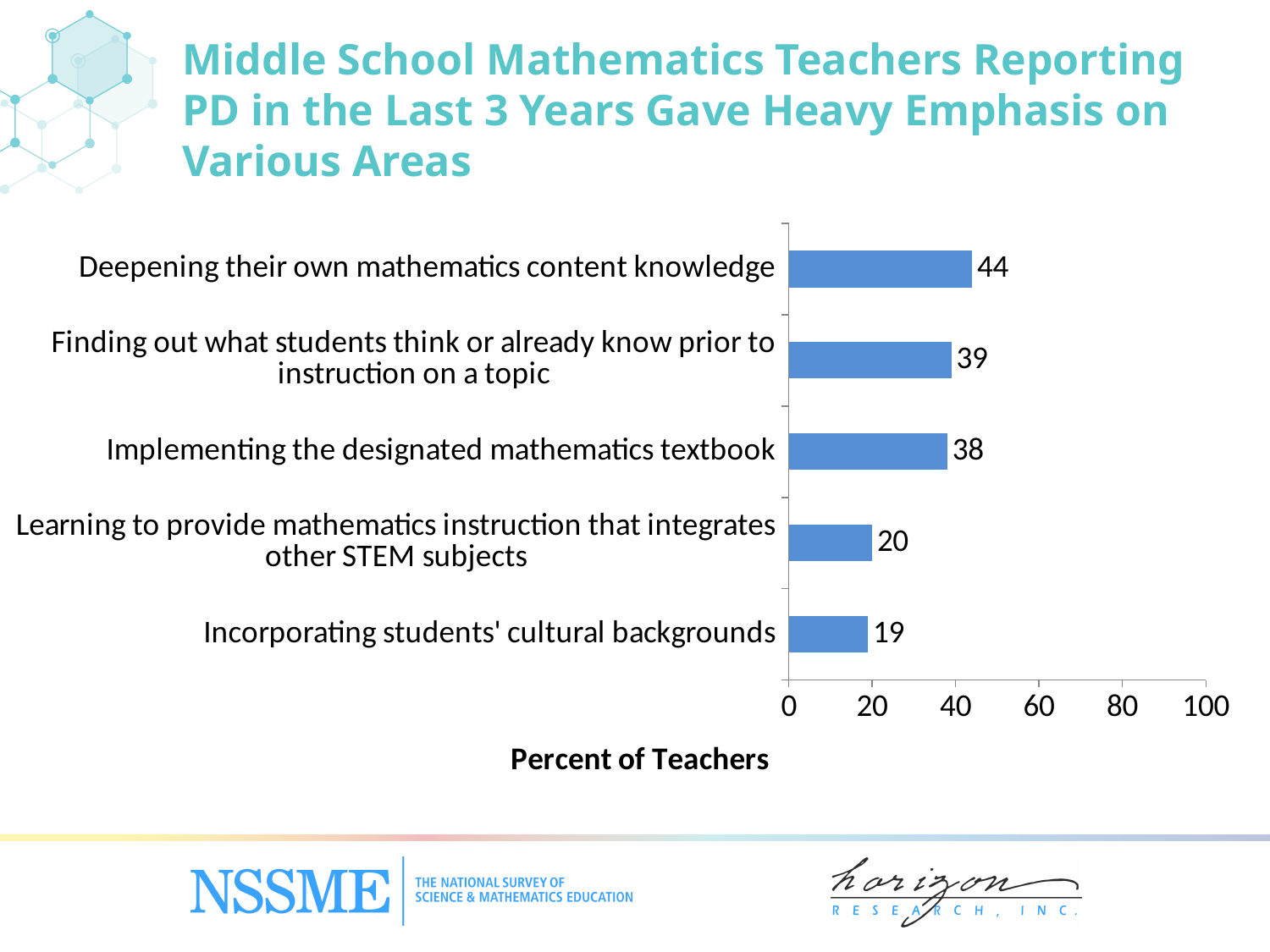
What is the value for 'Implementing the designated mathematics textbook'? 38 What kind of chart is shown on the slide? Bar chart Which area has the lowest percent of teachers? Incorporating students' cultural backgrounds Which area has the highest percent of teachers? Deepening their own mathematics content knowledge Which is larger: the value for 'Finding out what students think or already know prior to instruction on a topic' or the value for 'Learning to provide mathematics instruction that integrates other STEM subjects'? Finding out what students think or already know prior to instruction on a topic What is the label of the horizontal axis? Percent of Teachers What percent of teachers reported heavy emphasis on deepening their own mathematics content knowledge? 44 Is the value for 'Deepening their own mathematics content knowledge' greater or less than 40? greater How many areas are shown in the chart? 5 What is the value for 'Incorporating students' cultural backgrounds'? 19 What is the value for 'Learning to provide mathematics instruction that integrates other STEM subjects'? 20 What is the difference between the values for 'Deepening their own mathematics content knowledge' and 'Incorporating students' cultural backgrounds'? 25